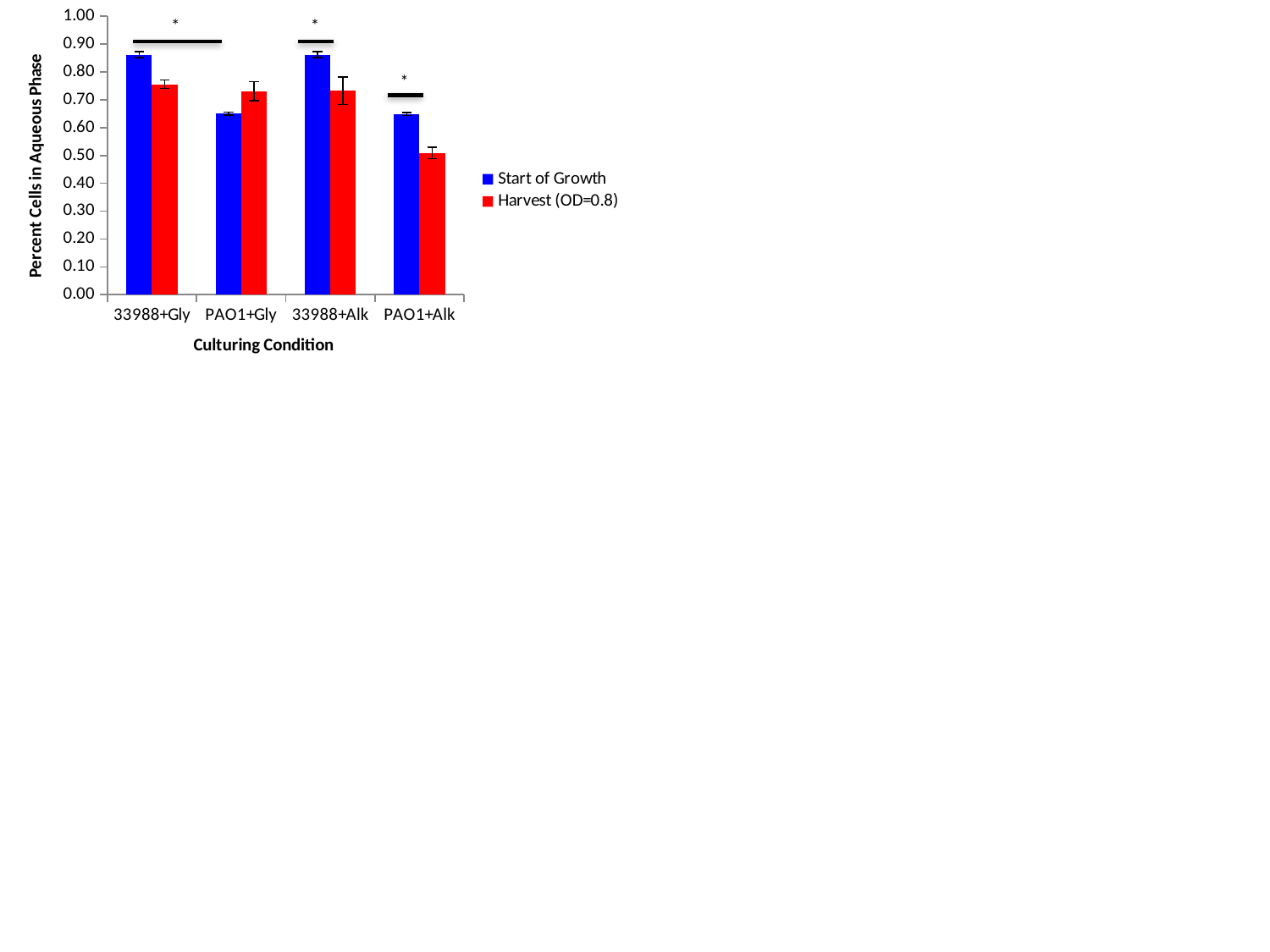
For 33988+Alk, which is larger: the Start of Growth value or the Harvest (OD=0.8) value? Start of Growth What is the title of the y axis? Percent Cells in Aqueous Phase For PAO1+Gly, which is larger: the Start of Growth value or the Harvest (OD=0.8) value? Harvest (OD=0.8) Which series is shown in red? Harvest (OD=0.8) Is the Harvest (OD=0.8) value for PAO1+Alk greater or less than 0.60? less Which culturing condition has the lowest Harvest (OD=0.8) value? PAO1+Alk Is the Start of Growth value for PAO1+Gly greater or less than 0.70? less Is the Harvest (OD=0.8) value for 33988+Gly greater or less than 0.70? greater How many culturing conditions are shown on the x axis? 4 What kind of chart is shown on the slide? bar chart How many series does the legend list? 2